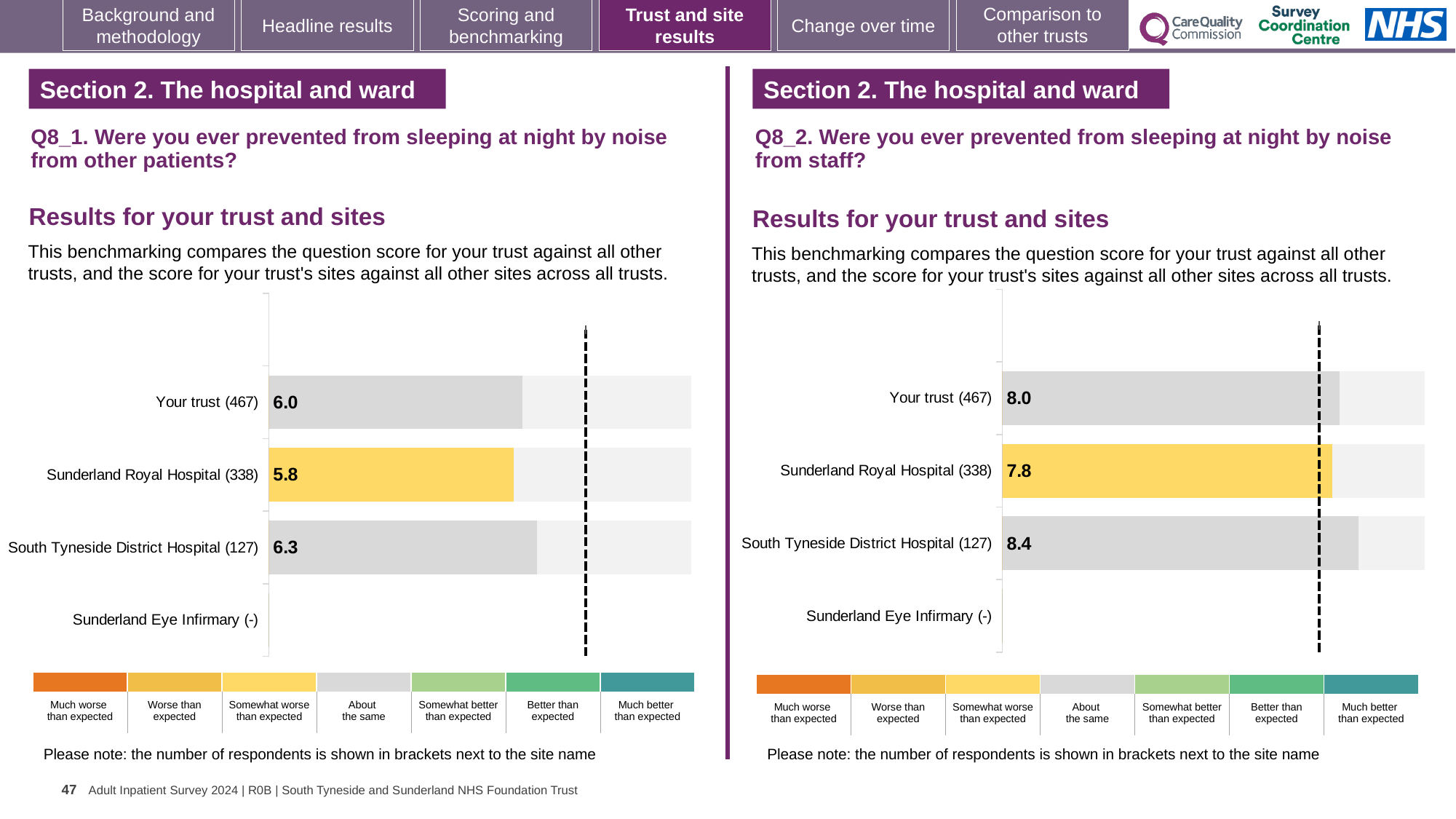
In the Q8_1 chart (noise from other patients), what is the score for Sunderland Royal Hospital? 5.8 In the Q8_2 chart (noise from staff), what is the difference between the scores for Your trust and Sunderland Royal Hospital? 0.2 In the Q8_1 chart (noise from other patients), how many respondents are shown in brackets for Your trust? 467 In the Q8_1 chart (noise from other patients), what is the score for Your trust? 6.0 In the Q8_1 chart (noise from other patients), which site or trust has the highest score? South Tyneside District Hospital In the Q8_2 chart (noise from staff), which has the larger score: Your trust or Sunderland Royal Hospital? Your trust In the Q8_2 chart (noise from staff), which site has the lowest score? Sunderland Royal Hospital How many rows (trust and sites) are listed on the Q8_1 chart (noise from other patients)? 4 In the Q8_2 chart (noise from staff), what is the score for South Tyneside District Hospital? 8.4 What kind of chart is used on the Q8_2 chart (noise from staff)? Bar chart In the Q8_1 chart (noise from other patients), what is the difference between the scores for South Tyneside District Hospital and Sunderland Royal Hospital? 0.5 In the Q8_2 chart (noise from staff), what is the score for Your trust? 8.0